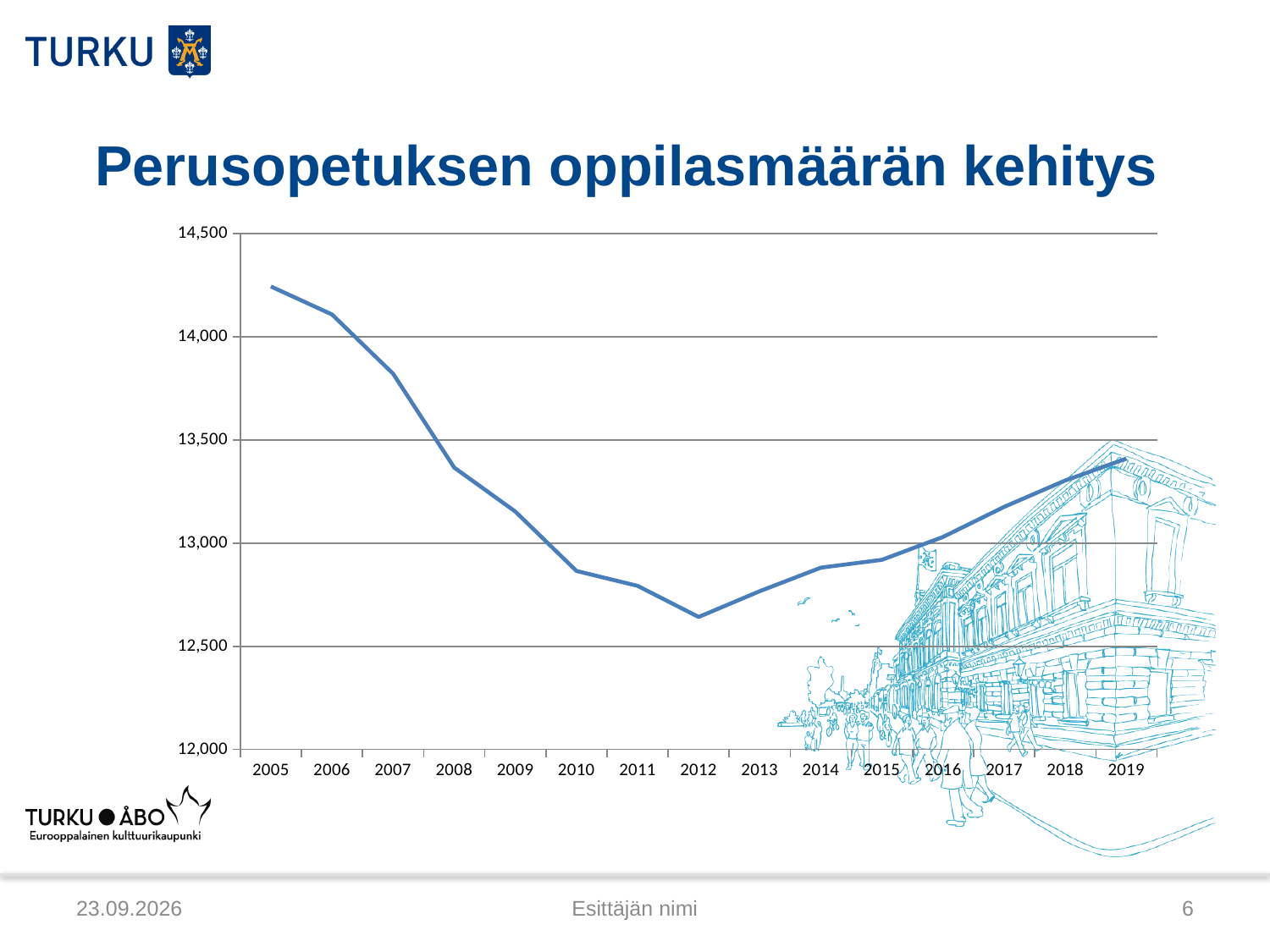
Which year has the lowest value in the chart? 2012 How many years are plotted along the x axis of the chart? 15 What kind of chart is shown on the slide? line chart Is the value for 2012 greater or less than 13,000? less Is the value for 2005 greater or less than 14,000? greater Is the value for 2019 greater or less than 13,000? greater What is the title of the chart on the slide? Perusopetuksen oppilasmäärän kehitys Which year has the highest value in the chart? 2005 Do the values rise or fall from 2005 to 2012? fall Which is larger, the value for 2005 or the value for 2019? 2005 Do the values rise or fall from 2012 to 2019? rise